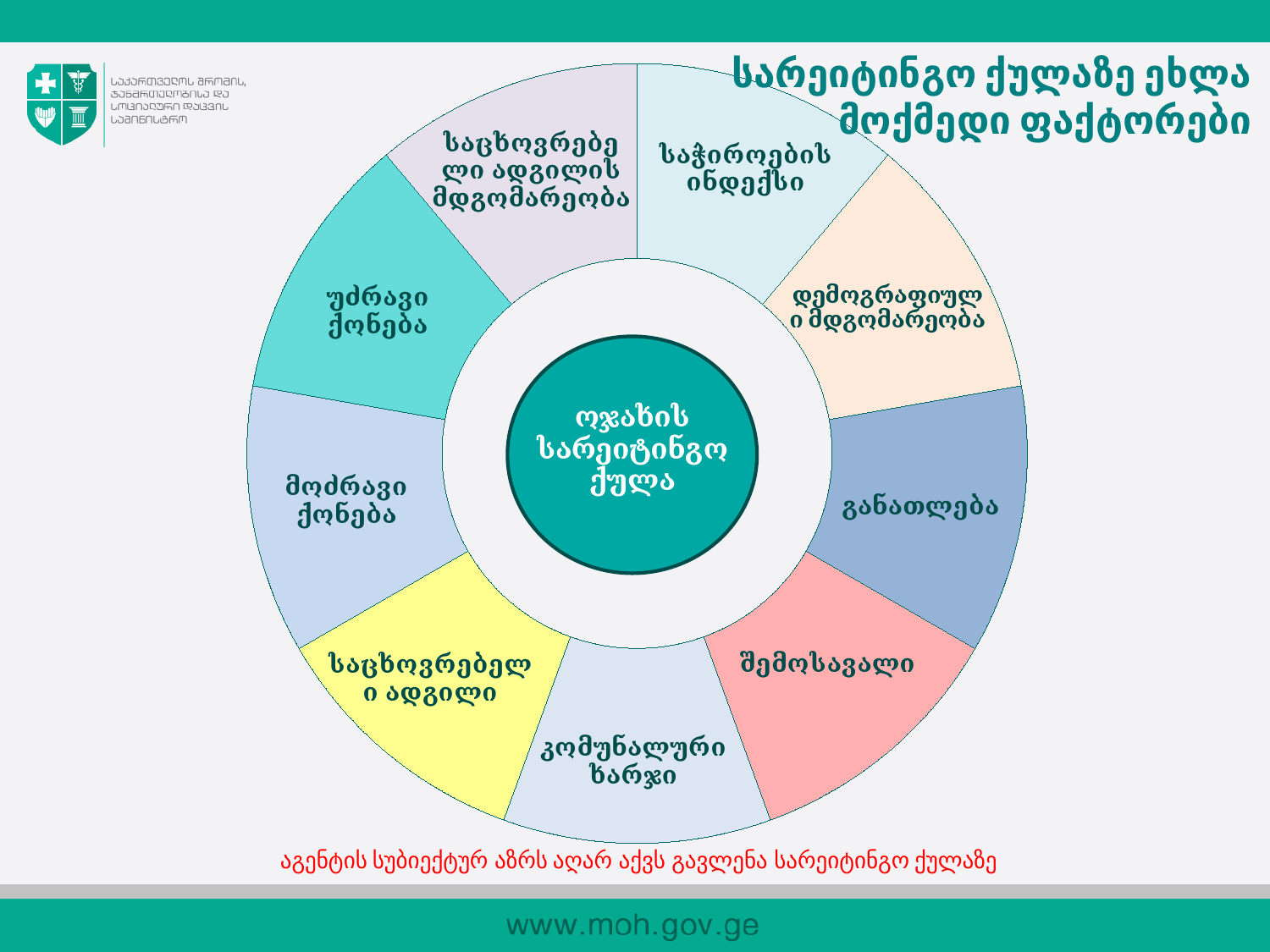
Which segment of the ring diagram is located directly to the right of the centre circle? განათლება Which segment of the ring diagram is located directly to the left of the centre circle? მოძრავი ქონება How many segments does the ring diagram on the slide contain? 9 What text is written in the centre circle of the ring diagram? ოჯახის სარეიტინგო ქულა What kind of chart is shown on the slide? Donut (ring) chart Which segment of the ring diagram is at the top, immediately to the right of the 12 o'clock position? საჭიროების ინდექსი What is the title of the diagram on the slide? სარეიტინგო ქულაზე ეხლა მოქმედი ფაქტორები Which segment of the ring diagram is at the bottom, between საცხოვრებელი ადგილი and შემოსავალი? კომუნალური ხარჯი